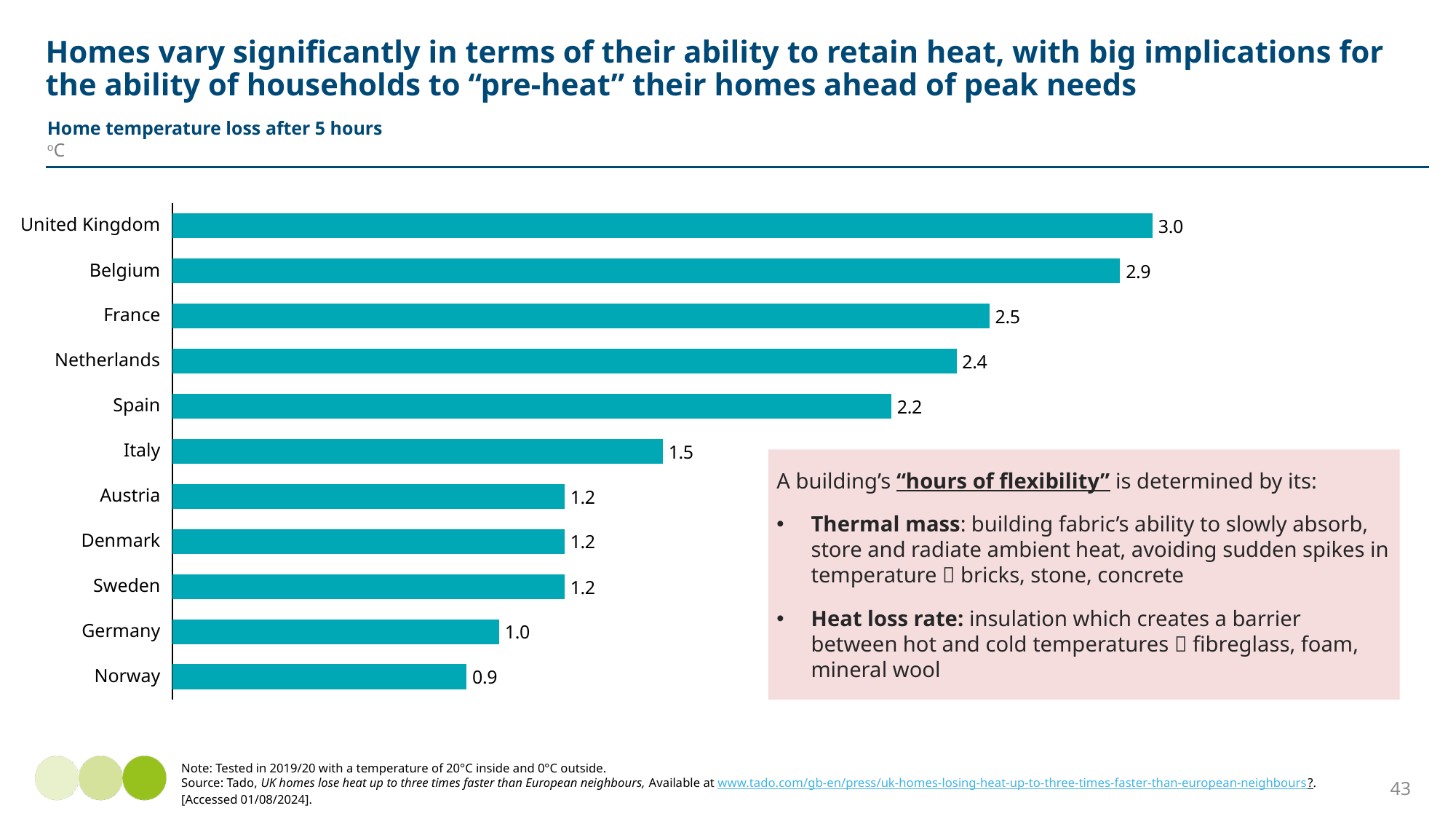
Which has a larger value, Italy or Germany? Italy What is the value shown for Germany? 1.0 Which country has the highest home temperature loss after 5 hours? United Kingdom Which country has the lowest home temperature loss after 5 hours? Norway How many countries are shown in the chart? 11 What unit is the chart measured in, as shown under the chart title? °C What is the difference between the values for France and Italy? 1.0 Which has a larger value, Belgium or the Netherlands? Belgium What is the difference between the values for the United Kingdom and Norway? 2.1 What kind of chart is used to show home temperature loss after 5 hours? Bar chart What is the home temperature loss after 5 hours for the United Kingdom? 3.0 What is the value shown for Spain? 2.2